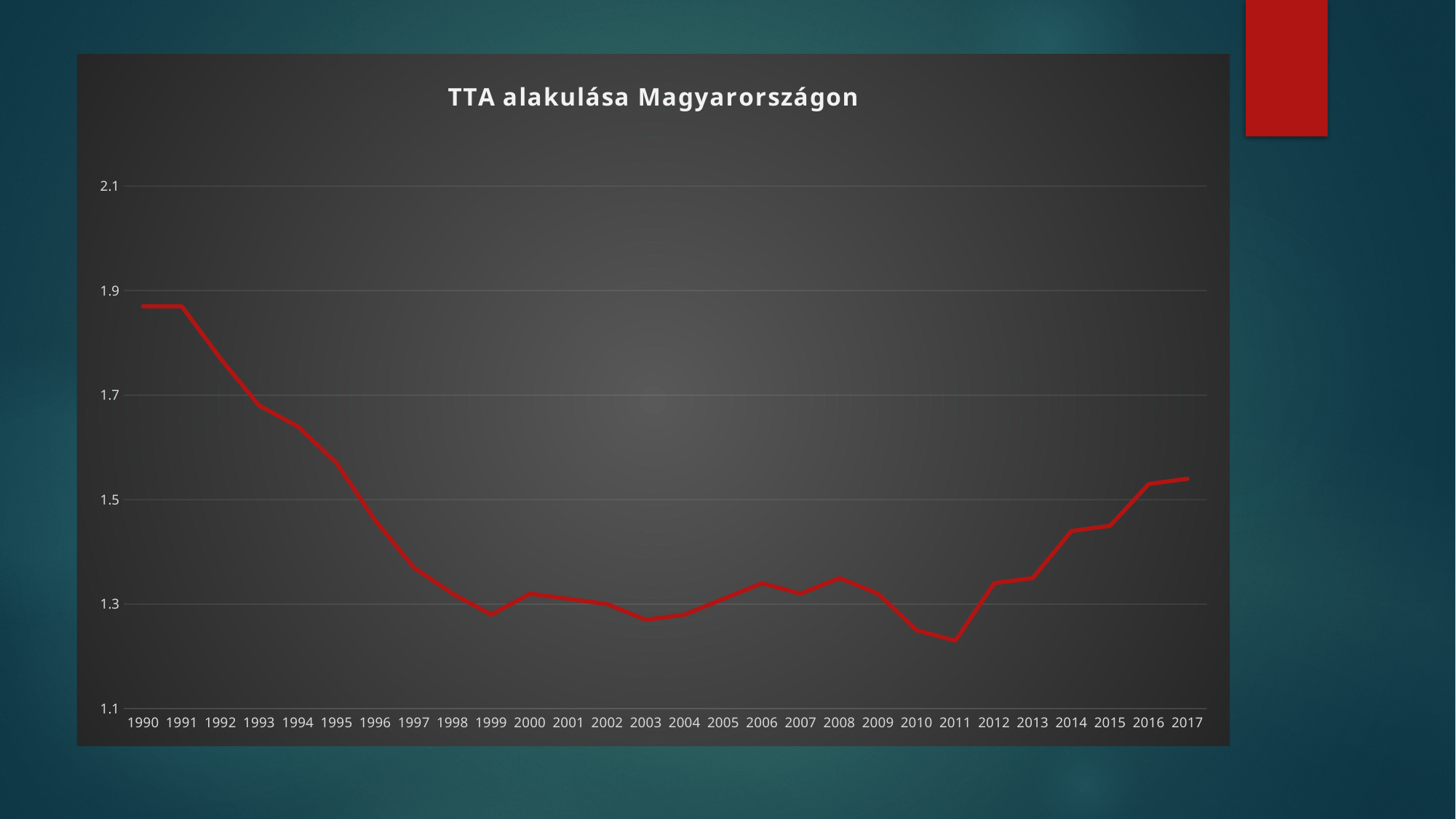
How many years are plotted along the x axis? 28 Which year has the larger value, 1990 or 2017? 1990 What is the title of the chart? TTA alakulása Magyarországon Which year has the larger value, 2011 or 2016? 2016 What kind of chart is shown on the slide? line chart Is the value for 1990 greater or less than 1.7? greater Is the value for 1997 greater or less than 1.5? less Is the value for 2017 greater or less than 1.5? greater Which year has the lowest value on the chart? 2011 Do the values rise or fall from 1991 to 1999? fall